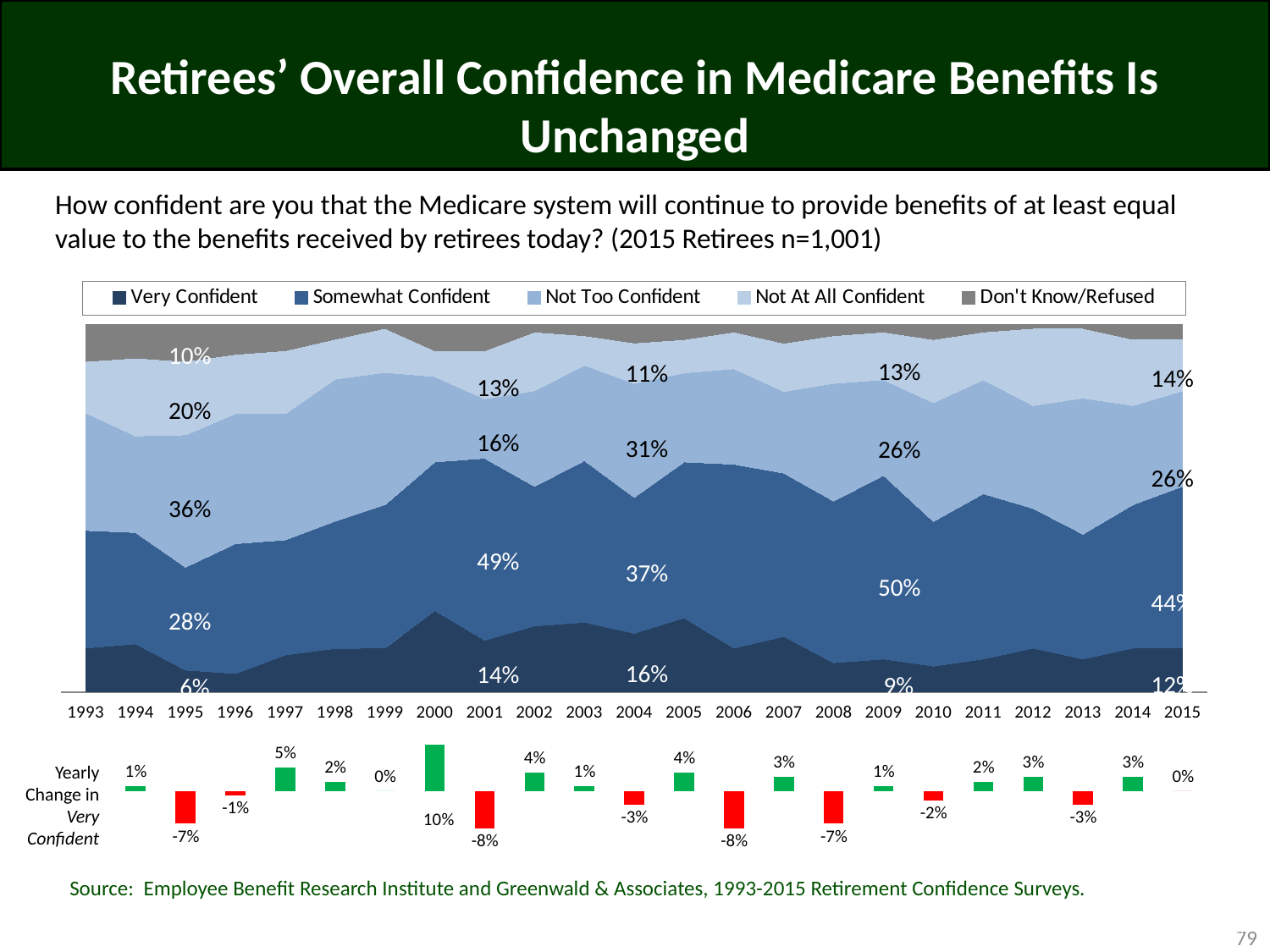
In the main chart, what percentage of retirees were Not At All Confident in 1995? 20% How many years are shown on the x axis of the main chart? 23 What kind of chart is the lower chart showing the yearly change in Very Confident? Bar chart In the main chart, what percentage of retirees were Very Confident in 2015? 12% In the main chart, what percentage of retirees were Not Too Confident in 2004? 31% In the main chart, what percentage of retirees were Somewhat Confident in 2009? 50% In the lower chart, what is the yearly change in Very Confident for 2008? -7% How many series does the legend of the main chart list? 5 In the lower chart, which year has the largest yearly change in Very Confident? 2000 In the main chart, what is the difference between the Somewhat Confident share in 2001 and in 2004? 12% In the main chart, which is larger: the Very Confident share in 2004 or in 2009? 2004 What kind of chart is the main chart showing confidence levels? Stacked area chart